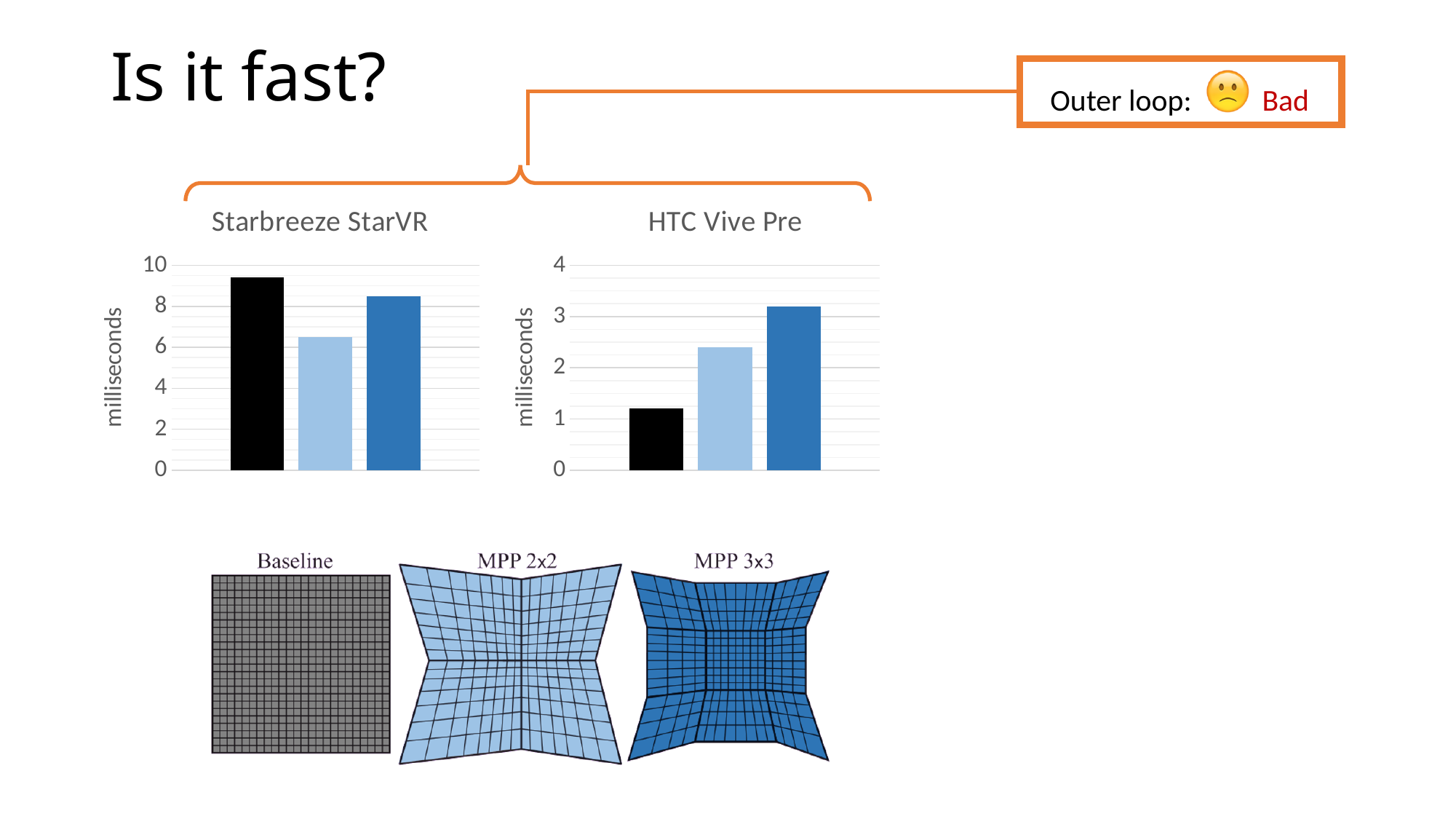
What is the y-axis label on the Starbreeze StarVR chart? milliseconds What kind of chart is the Starbreeze StarVR chart? bar chart In the HTC Vive Pre chart, which bar is the shortest: the black, the light blue, or the dark blue bar? the black bar In the HTC Vive Pre chart, is the value of the dark blue bar greater or less than 3 milliseconds? greater In the Starbreeze StarVR chart, is the value of the black bar greater or less than 8 milliseconds? greater In the HTC Vive Pre chart, which bar is the tallest: the black, the light blue, or the dark blue bar? the dark blue bar How many bars are plotted in the HTC Vive Pre chart? 3 In the Starbreeze StarVR chart, which bar is the shortest: the black, the light blue, or the dark blue bar? the light blue bar In the Starbreeze StarVR chart, which bar is the tallest: the black, the light blue, or the dark blue bar? the black bar In the HTC Vive Pre chart, is the value of the black bar greater or less than 2 milliseconds? less In the HTC Vive Pre chart, which is larger: the light blue bar or the black bar? the light blue bar